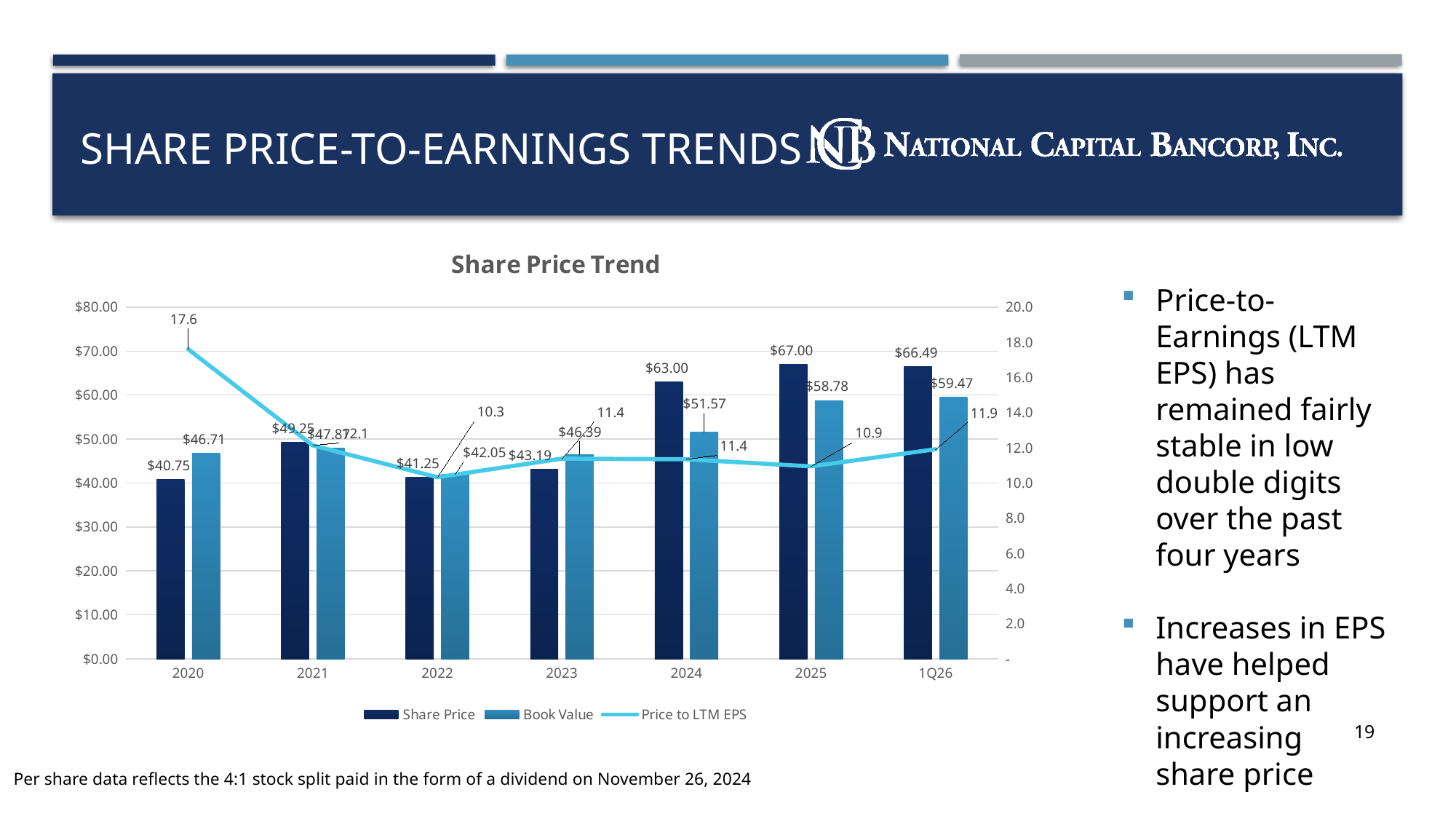
What is the difference between the Share Price and the Book Value in 2025? $8.22 Which year has the lowest Price to LTM EPS? 2022 In 2020, which is larger: the Share Price or the Book Value? Book Value What is the Share Price for 2024? $63.00 Which year has the highest Share Price? 2025 What is the Price to LTM EPS value for 2020? 17.6 What is the title of the chart? Share Price Trend What is the Book Value for 1Q26? $59.47 What kind of chart is this? Combination bar and line chart Does the Price to LTM EPS line rise or fall from 2020 to 2022? Fall How many series does the legend list? 3 How many periods are shown on the x axis? 7